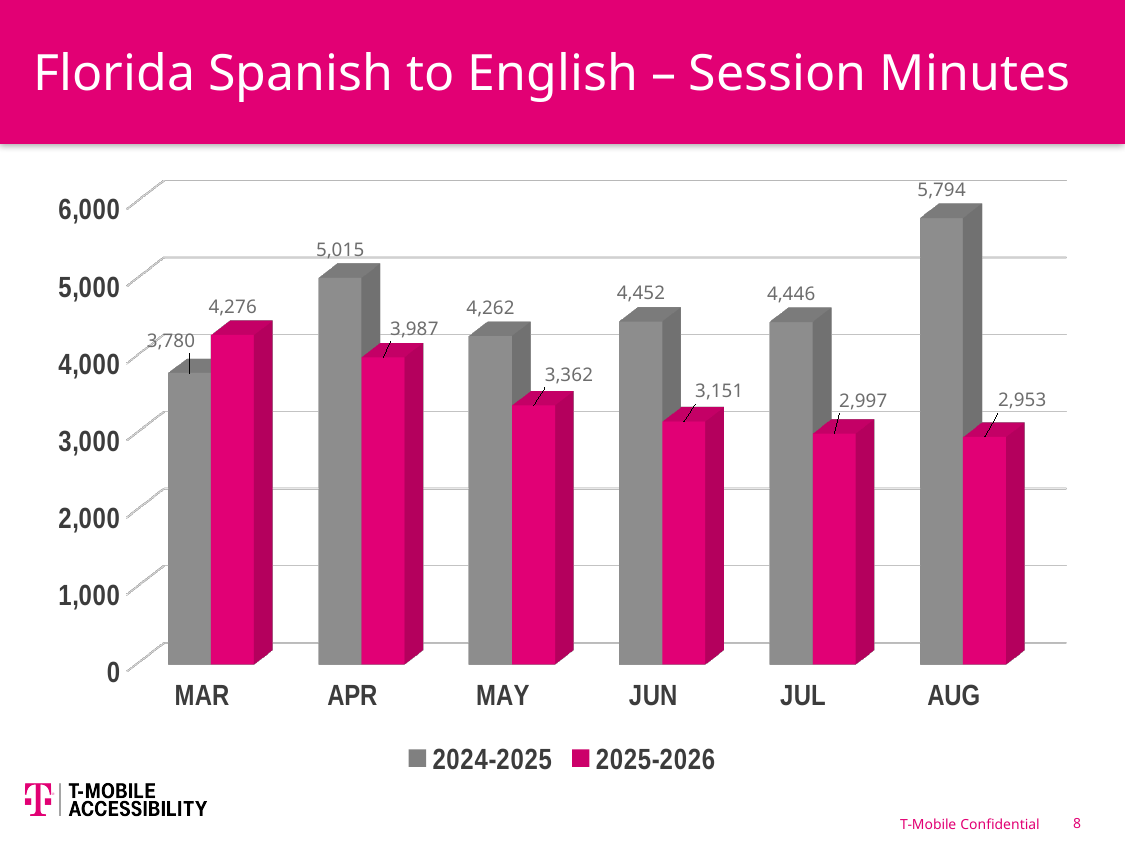
How many series does the legend list? 2 What is the 2024-2025 value for AUG? 5,794 What is the 2024-2025 value for MAR? 3,780 Which is larger for MAR, the 2024-2025 value or the 2025-2026 value? 2025-2026 Which month has the lowest 2025-2026 value? AUG How many months are shown on the x axis? 6 Which month has the highest 2024-2025 value? AUG Do the 2025-2026 values rise or fall from MAR to AUG? fall Is the 2025-2026 value for JUL greater or less than 3,000? less What is the 2025-2026 value for MAY? 3,362 What is the difference between the 2024-2025 and 2025-2026 values for AUG? 2,841 What kind of chart is shown on the slide? bar chart